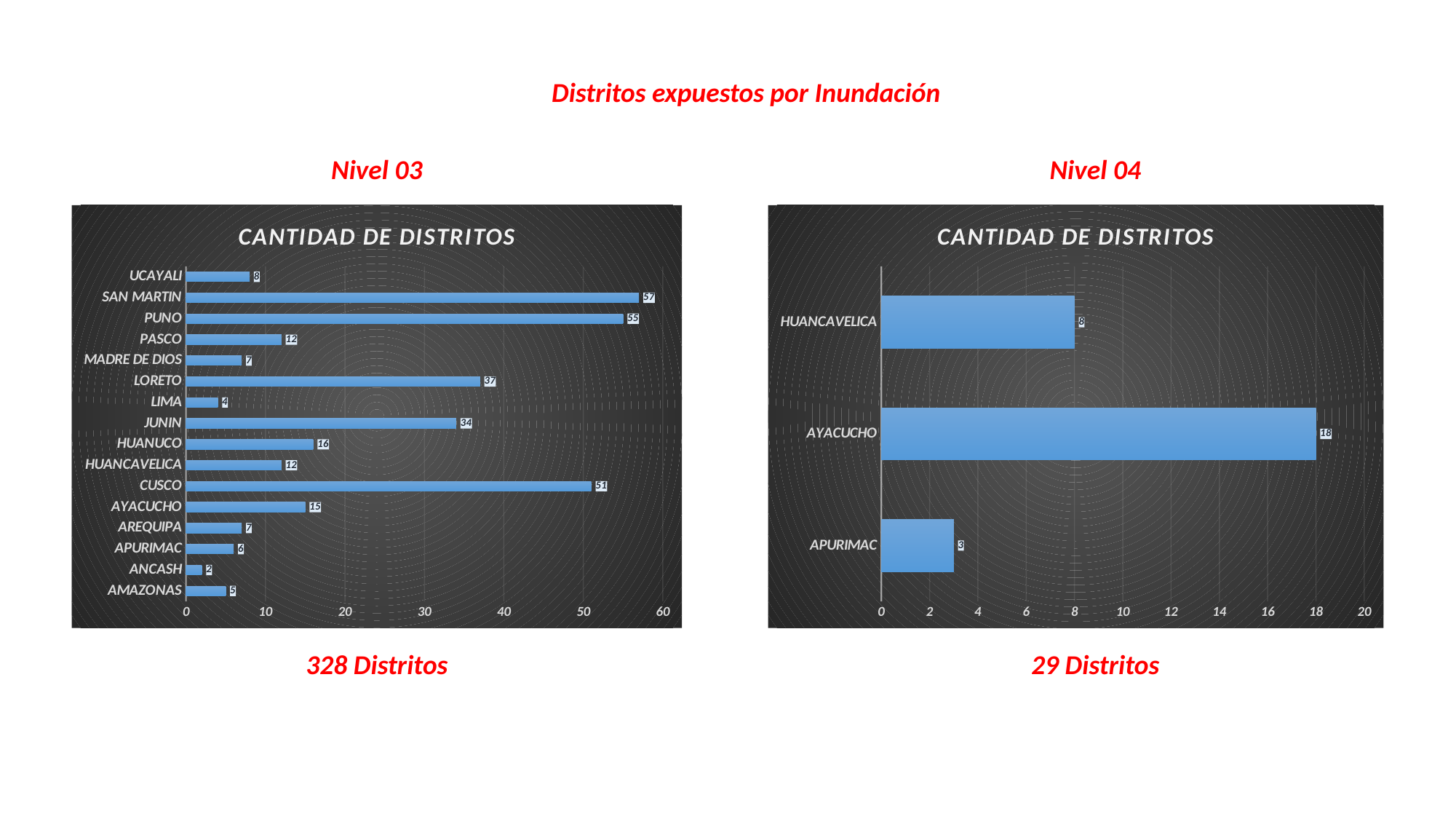
In the Nivel 04 chart, which category has the lowest value? APURIMAC In the Nivel 04 chart, what is the value for AYACUCHO? 18 In the Nivel 03 chart, which category has the highest value? SAN MARTIN In the Nivel 03 chart, what is the difference between the values for PUNO and CUSCO? 4 In the Nivel 03 chart, which category has the lowest value? ANCASH In the Nivel 03 chart, which is larger, the value for JUNIN or the value for HUANUCO? JUNIN How many categories are shown in the Nivel 03 chart? 16 What type of chart is the Nivel 04 chart? Bar chart In the Nivel 03 chart, what is the value for SAN MARTIN? 57 In the Nivel 04 chart, what is the difference between the values for AYACUCHO and HUANCAVELICA? 10 How many categories are shown in the Nivel 04 chart? 3 In the Nivel 03 chart, what is the value for LORETO? 37